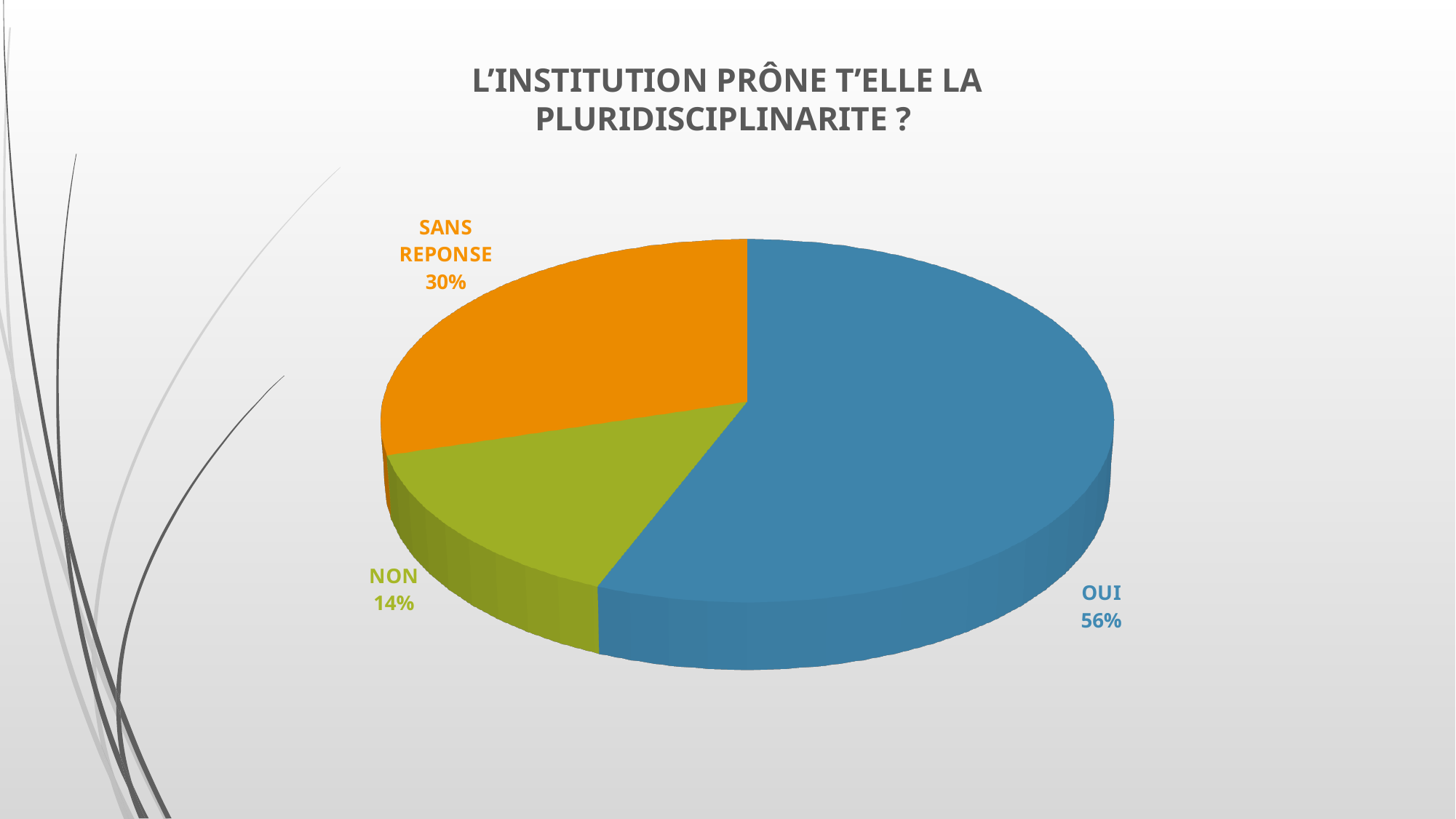
What share of the pie does OUI represent? 56% Which category has the largest slice of the pie? OUI What is the difference in percentage points between SANS REPONSE and NON? 16 What kind of chart is shown on the slide? Pie chart What colour is the OUI slice? Blue What is the title of the chart? L'INSTITUTION PRÔNE T'ELLE LA PLURIDISCIPLINARITE ? How many categories are shown in the pie chart? 3 What is the difference in percentage points between OUI and SANS REPONSE? 26 What share of the pie does SANS REPONSE represent? 30% Which is larger, the share for NON or the share for SANS REPONSE? SANS REPONSE What share of the pie does NON represent? 14% Which category has the smallest slice of the pie? NON